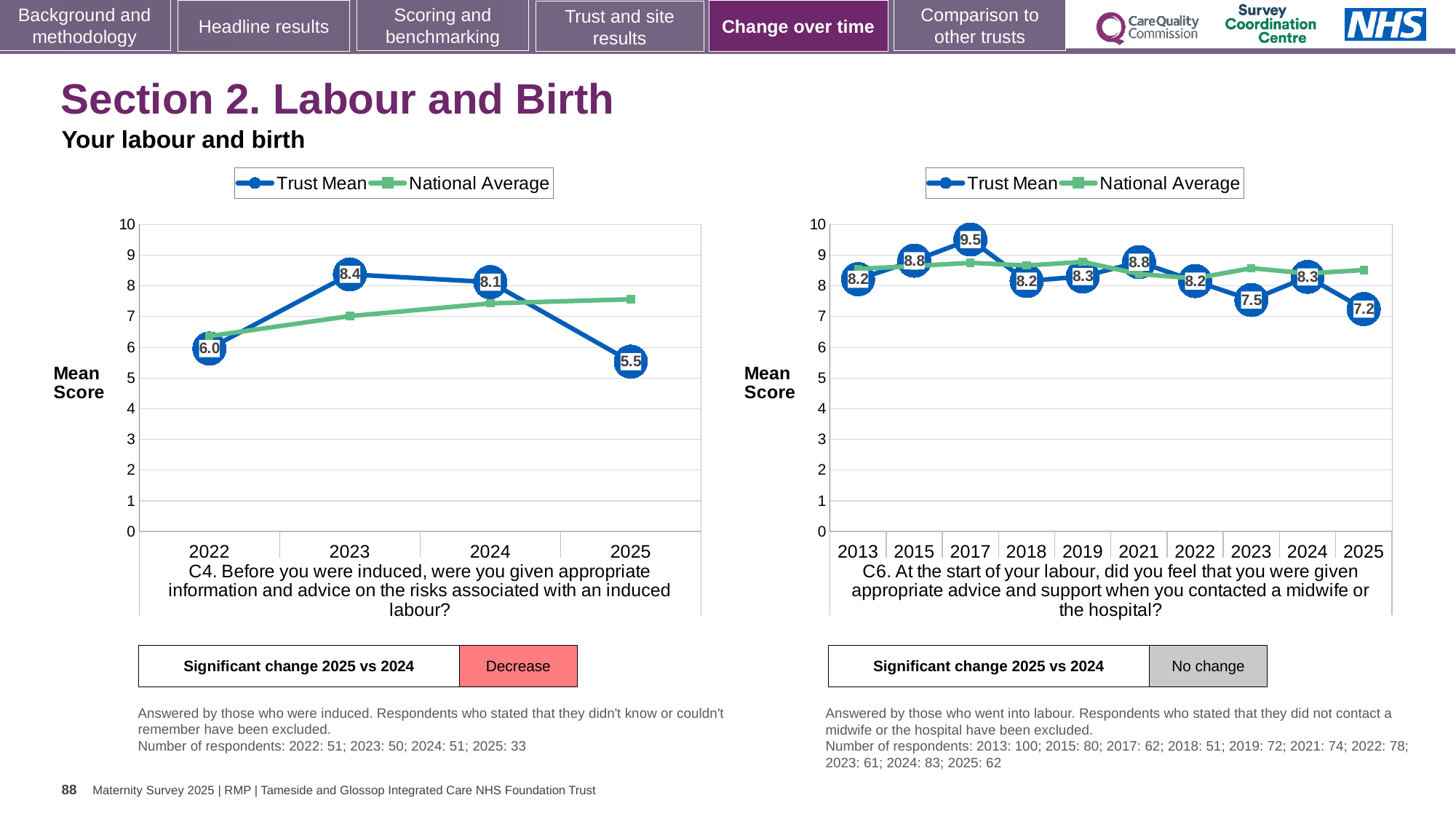
In the C6 chart (right), what is the Trust Mean for 2017? 9.5 In the C6 chart (right), is the Trust Mean for 2023 larger or smaller than the Trust Mean for 2024? smaller What type of chart is the C6 chart (right)? Line chart In the C6 chart (right), which year has the lowest Trust Mean? 2025 In the C4 chart (left), what is the Trust Mean for 2025? 5.5 In the C4 chart (left), what is the difference between the Trust Mean for 2023 and the Trust Mean for 2025? 2.9 In the C6 chart (right), which year has the highest Trust Mean? 2017 In the C4 chart (left), is the National Average for 2025 greater or less than 7? greater In the C4 chart (left), what is the Trust Mean for 2023? 8.4 In the C6 chart (right), how many years are shown on the x axis? 10 In the C4 chart (left), how many years are shown on the x axis? 4 In the C4 chart (left), which year has the lowest Trust Mean? 2025